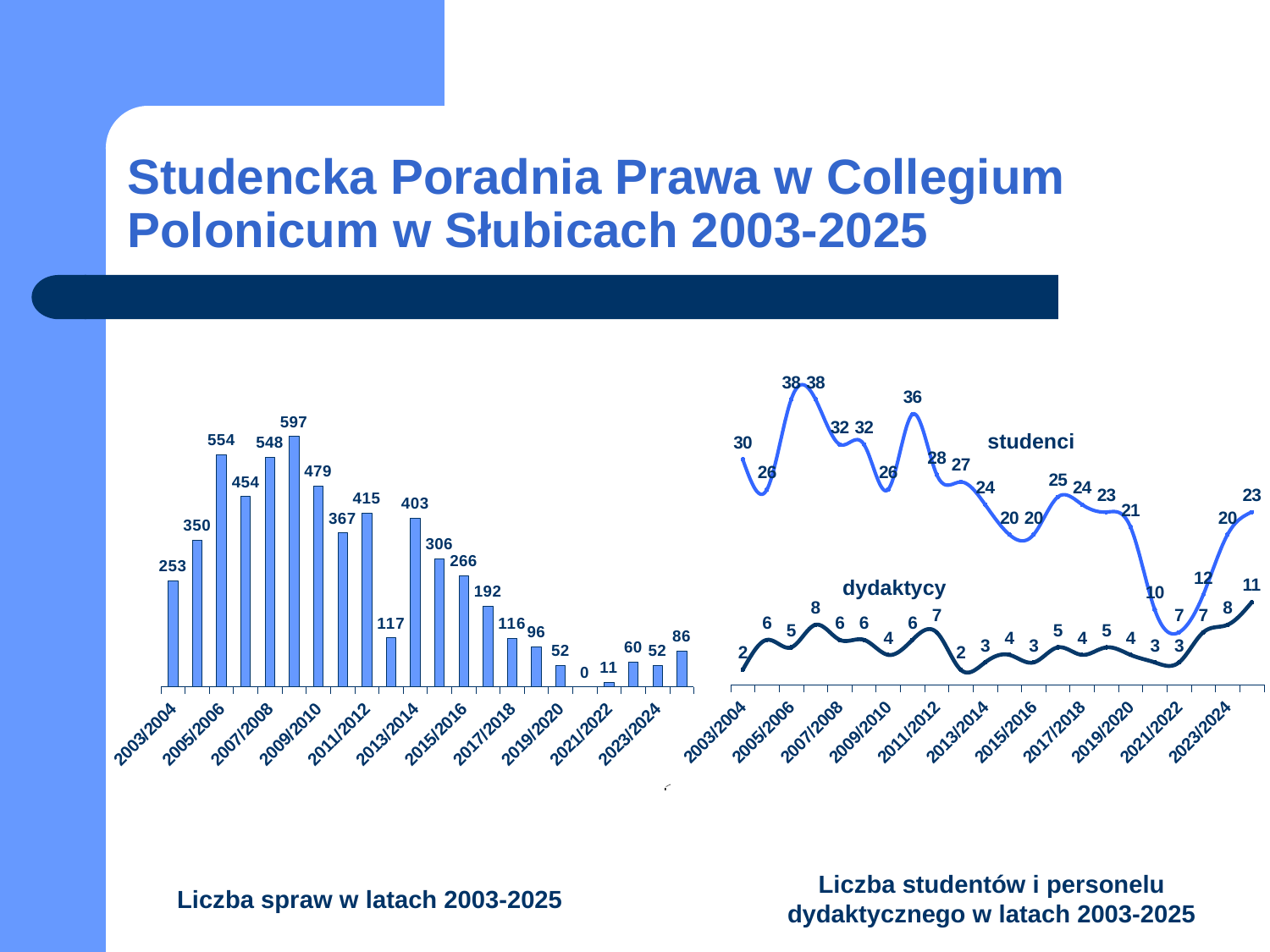
In the right chart (Liczba studentów i personelu dydaktycznego), what is the studenci value for 2023/2024? 20 How many bars are plotted in the left chart (Liczba spraw w latach 2003-2025)? 22 In the left chart (Liczba spraw w latach 2003-2025), what is the difference between the values for 2005/2006 and 2007/2008? 6 How many series are plotted in the right chart (Liczba studentów i personelu dydaktycznego)? 2 In the right chart (Liczba studentów i personelu dydaktycznego), what is the highest studenci value? 38 What kind of chart is the left chart (Liczba spraw w latach 2003-2025)? bar chart In the left chart (Liczba spraw w latach 2003-2025), what is the value for 2003/2004? 253 In the right chart (Liczba studentów i personelu dydaktycznego), what is the dydaktycy value for 2023/2024? 8 What kind of chart is the right chart (Liczba studentów i personelu dydaktycznego)? line chart In the left chart (Liczba spraw w latach 2003-2025), what is the highest value shown? 597 In the left chart (Liczba spraw w latach 2003-2025), what is the lowest value shown? 0 In the right chart (Liczba studentów i personelu dydaktycznego), which year has the larger studenci value, 2003/2004 or 2013/2014? 2003/2004